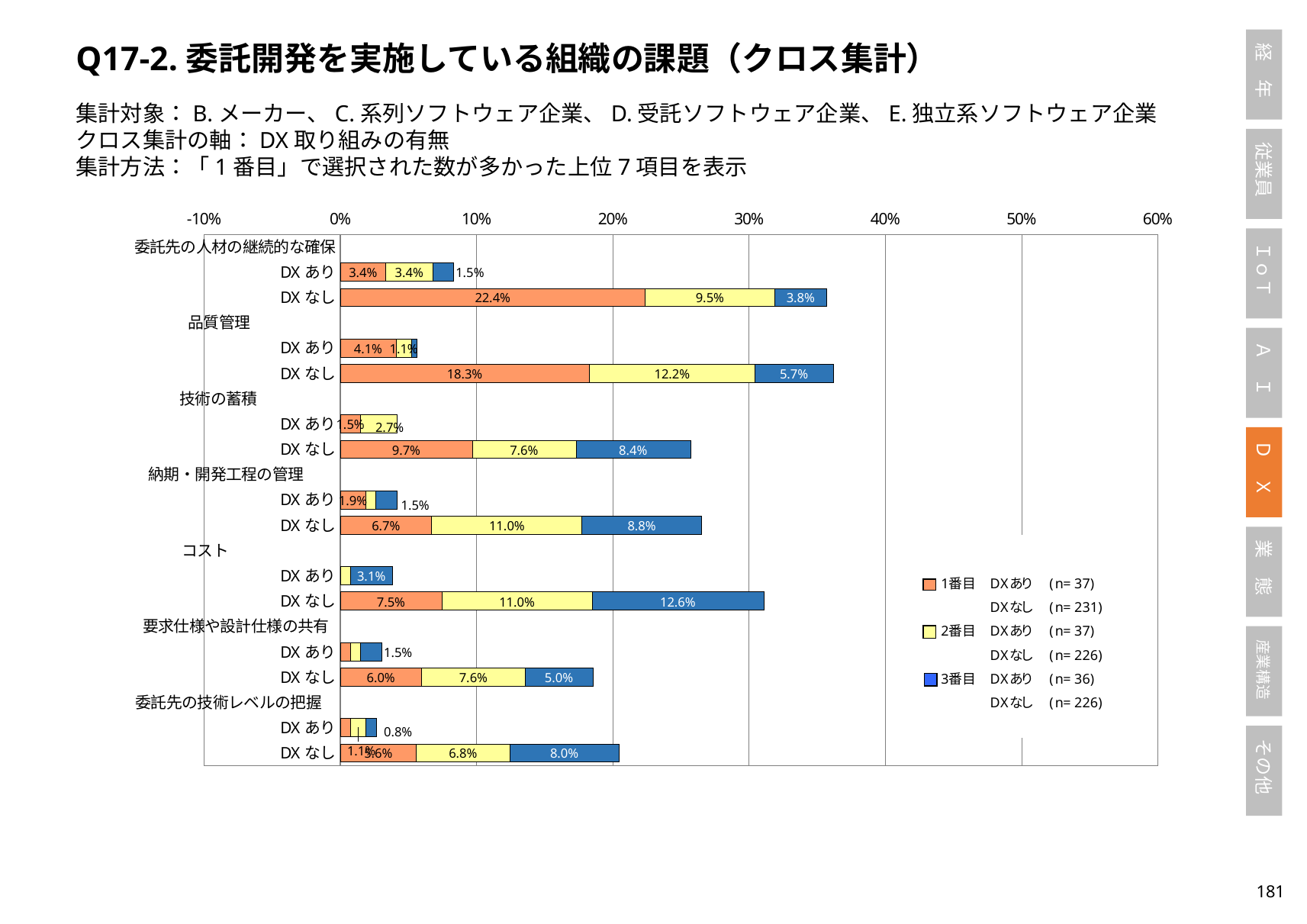
What is the 1番目 value for DX あり under 品質管理? 4.1% How many series does the legend list? 3 What is the 2番目 value for DX なし under 品質管理? 12.2% What is the total of the DX なし stacked bar for コスト? 31.1% Is the total DX なし bar for 品質管理 greater or less than 30%? greater What is the 1番目 value for DX なし under 委託先の人材の継続的な確保? 22.4% What kind of chart is shown on the slide? stacked bar chart Which category has the highest 1番目 value for DX なし? 委託先の人材の継続的な確保 What is the 3番目 value for DX なし under コスト? 12.6% What is the difference between the 1番目 DX なし values for 委託先の人材の継続的な確保 and 品質管理? 4.1% Which is larger: the 3番目 DX なし value for 納期・開発工程の管理 or for 技術の蓄積? 納期・開発工程の管理 What is the total of the DX なし stacked bar for 技術の蓄積? 25.7%